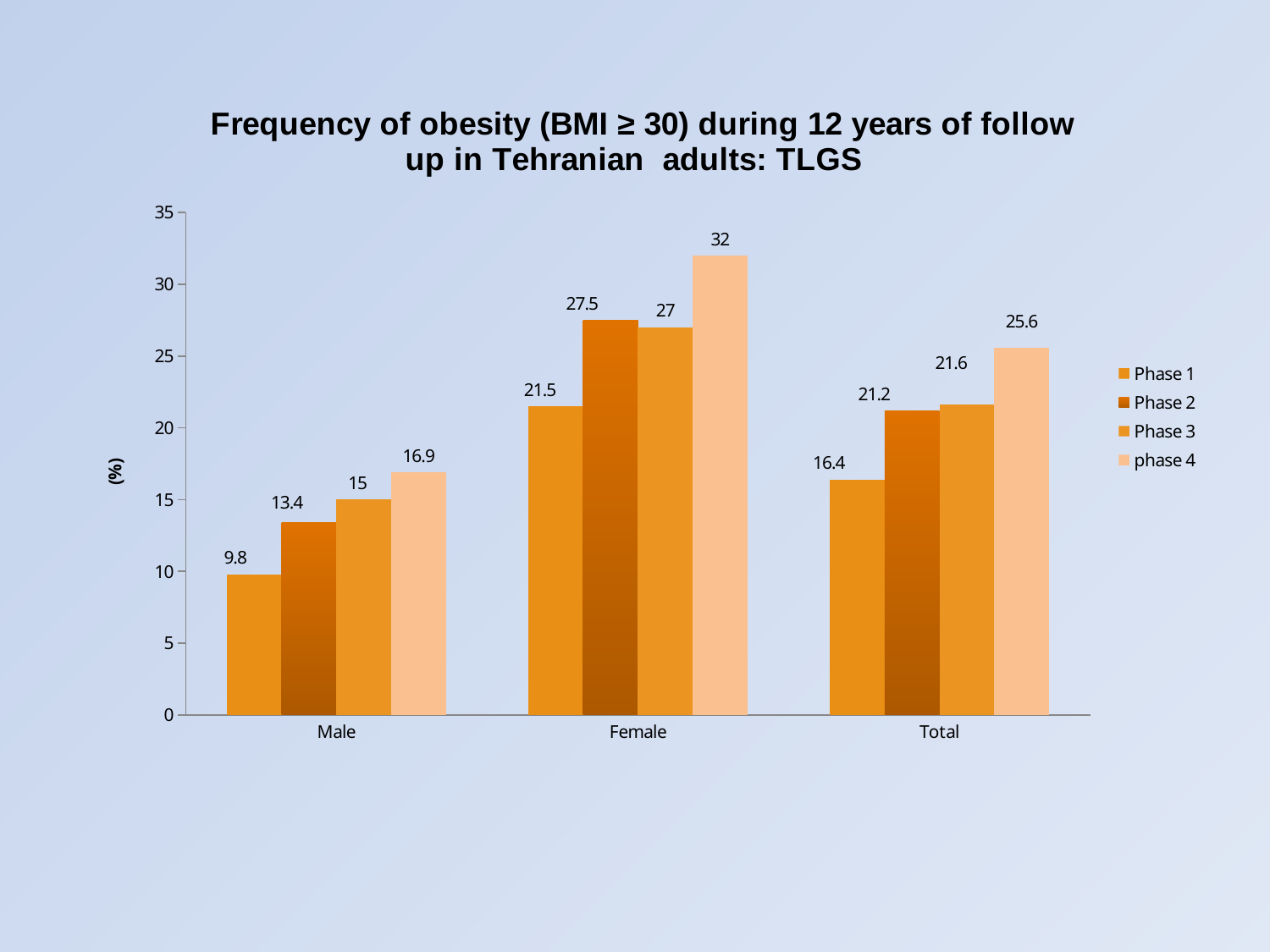
Which is larger for Female: the Phase 2 value or the Phase 3 value? Phase 2 How many categories are shown on the x axis? 3 Which category has the lowest value in phase 4? Male What is the label on the vertical axis? (%) What is the difference between the Female and Male values in Phase 1? 11.7 What kind of chart is shown on the slide? Bar chart What is the value for Female in phase 4? 32 What is the value for Male in Phase 1? 9.8 How many series does the legend list? 4 Do the values for Male rise or fall from Phase 1 to phase 4? Rise What is the value for Total in Phase 3? 21.6 Which category has the highest value in Phase 2? Female